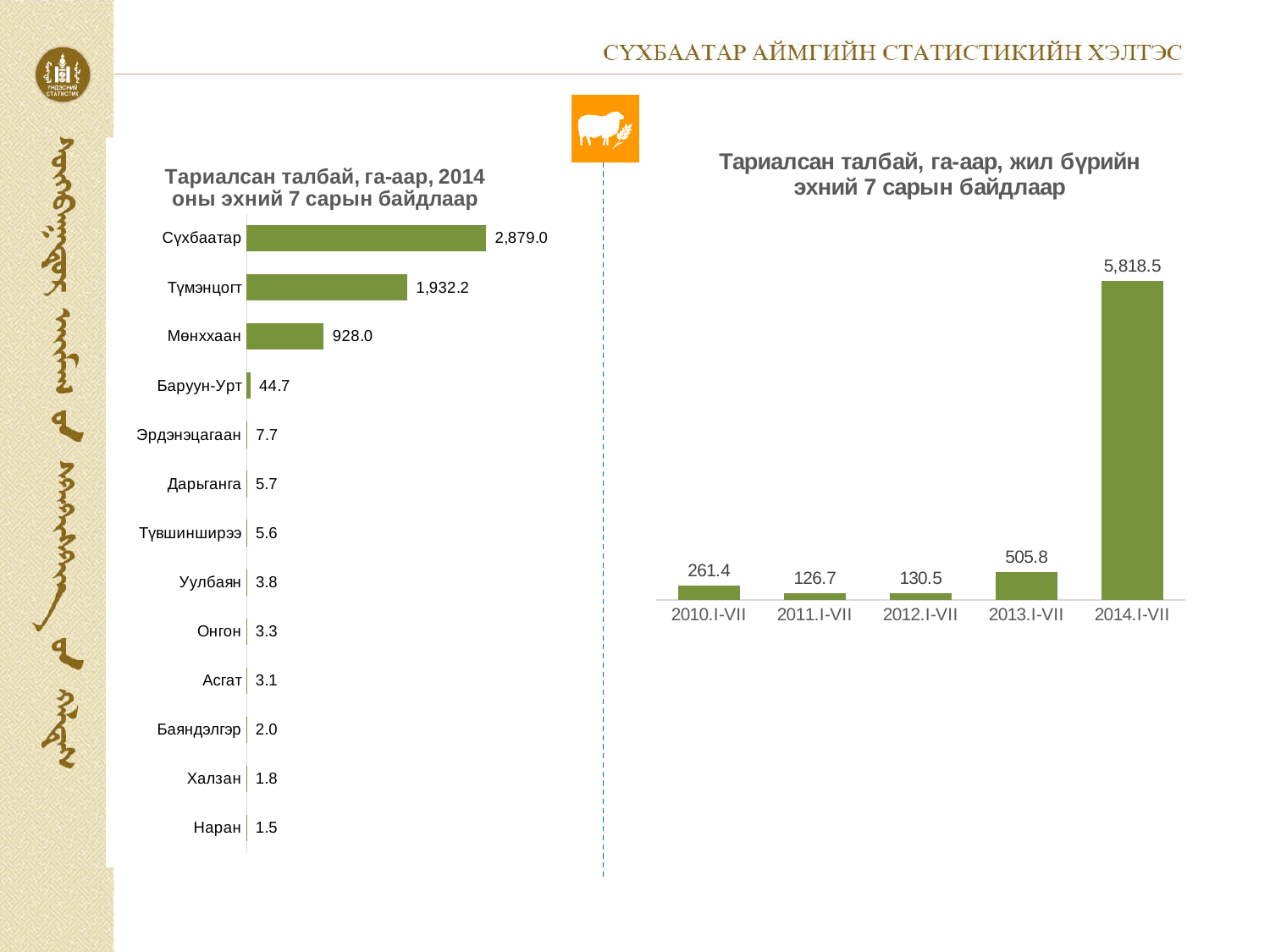
In the right chart (Тариалсан талбай, га-аар, жил бүрийн эхний 7 сарын байдлаар), what is the difference between 2014.I-VII and 2013.I-VII? 5,312.7 In the right chart (Тариалсан талбай, га-аар, жил бүрийн эхний 7 сарын байдлаар), what is the value for 2011.I-VII? 126.7 In the right chart (Тариалсан талбай, га-аар, жил бүрийн эхний 7 сарын байдлаар), which period has the lowest value? 2011.I-VII In the right chart (Тариалсан талбай, га-аар, жил бүрийн эхний 7 сарын байдлаар), how many periods are shown on the x axis? 5 What kind of chart is the left chart (Тариалсан талбай, га-аар, 2014 оны эхний 7 сарын байдлаар)? Bar chart In the left chart (Тариалсан талбай, га-аар, 2014 оны эхний 7 сарын байдлаар), how many categories are shown? 13 In the right chart (Тариалсан талбай, га-аар, жил бүрийн эхний 7 сарын байдлаар), what is the value for 2014.I-VII? 5,818.5 In the left chart (Тариалсан талбай, га-аар, 2014 оны эхний 7 сарын байдлаар), what is the value for Сүхбаатар? 2,879.0 In the left chart (Тариалсан талбай, га-аар, 2014 оны эхний 7 сарын байдлаар), which is larger, Баруун-Урт or Эрдэнэцагаан? Баруун-Урт In the left chart (Тариалсан талбай, га-аар, 2014 оны эхний 7 сарын байдлаар), what is the value for Мөнххаан? 928.0 In the left chart (Тариалсан талбай, га-аар, 2014 оны эхний 7 сарын байдлаар), what is the difference between Сүхбаатар and Түмэнцогт? 946.8 In the left chart (Тариалсан талбай, га-аар, 2014 оны эхний 7 сарын байдлаар), which category has the lowest value? Наран